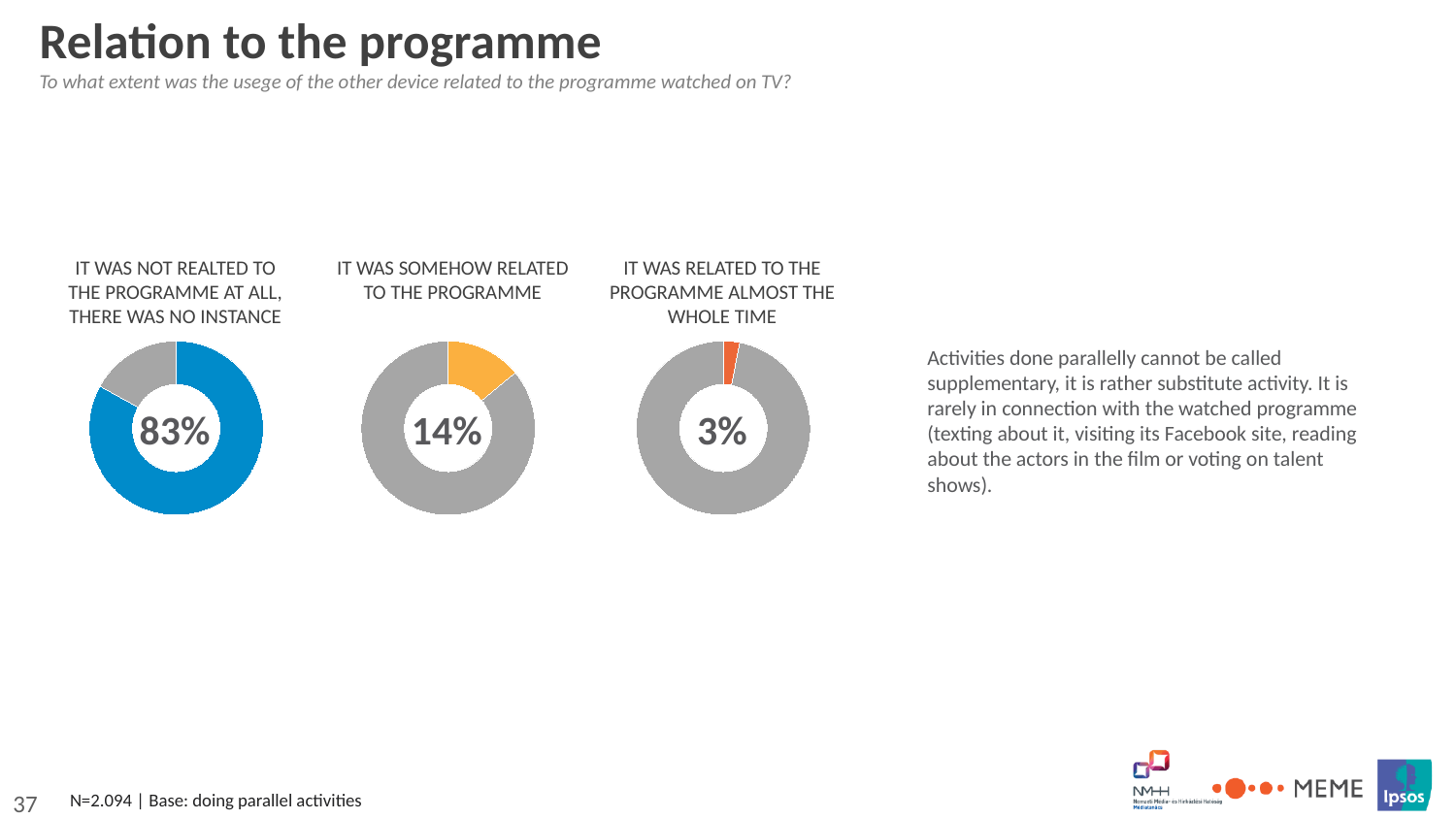
What colour is the highlighted segment in the donut chart showing 14%? Orange/yellow Which of the three donut charts shows the lowest percentage? It was related to the programme almost the whole time What percentage is shown in the donut chart labelled 'It was somehow related to the programme'? 14% What type of chart is used to display the three percentages on the slide? Donut chart Which of the three donut charts shows the highest percentage? It was not related to the programme at all, there was no instance Which is larger: the percentage for 'somehow related to the programme' or for 'related to the programme almost the whole time'? It was somehow related to the programme What percentage is shown in the donut chart labelled 'It was related to the programme almost the whole time'? 3% What is the difference in percentage points between the 'not related at all' chart and the 'somehow related' chart? 69 What is the difference in percentage points between the 'somehow related' chart and the 'related almost the whole time' chart? 11 How many donut charts are shown on the slide? 3 What colour is the highlighted segment in the donut chart showing 83%? Blue What percentage is shown in the donut chart labelled 'It was not related to the programme at all, there was no instance'? 83%